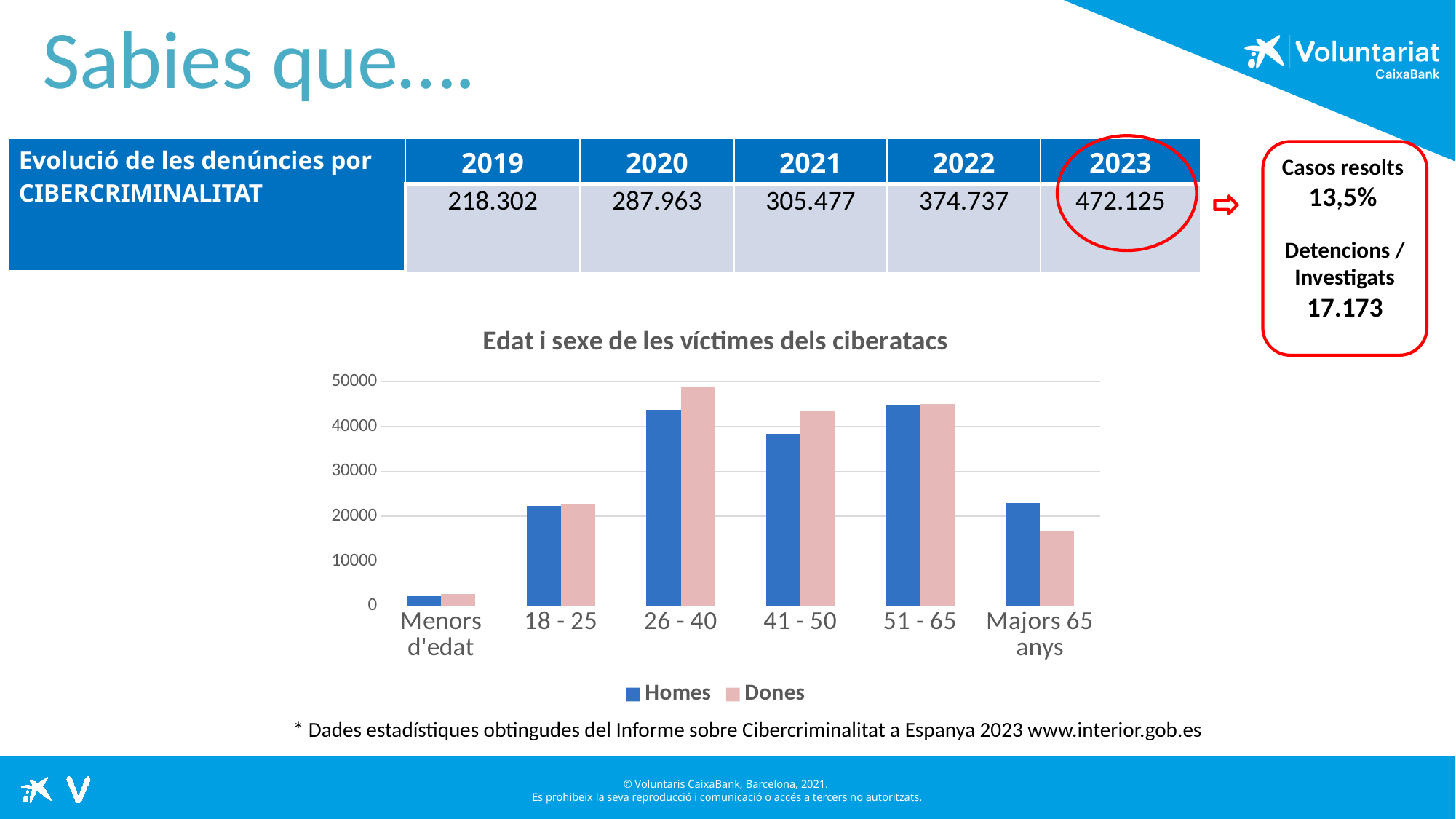
Is the value for Homes in the "18 - 25" category greater or less than 20000? greater In the "Majors 65 anys" category, which series has the larger value, Homes or Dones? Homes What are the two series named in the chart legend? Homes and Dones How many series does the legend of the chart list? 2 Is the value for Homes in the "41 - 50" category greater or less than 40000? less In the "26 - 40" category, which series has the larger value, Homes or Dones? Dones Is the value for Dones in the "Majors 65 anys" category greater or less than 20000? less Which age category has the lowest value for Homes? Menors d'edat Which age category has the highest value for Dones? 26 - 40 What kind of chart is "Edat i sexe de les víctimes dels ciberatacs"? bar chart Which age category has the lowest value for Dones? Menors d'edat How many age categories are shown on the x axis of the chart? 6